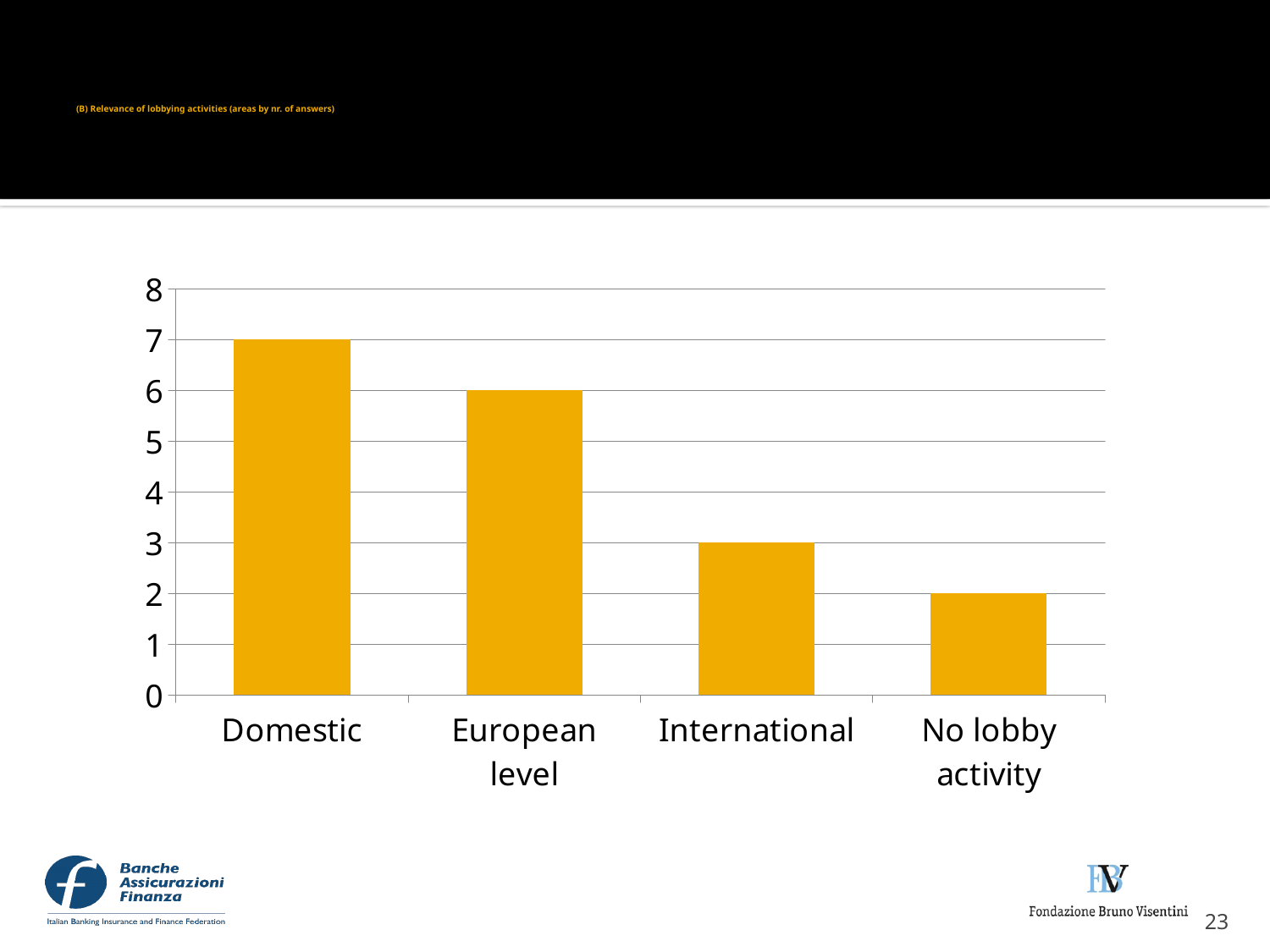
What is the value for European level? 6 Which category has the lowest value? No lobby activity Which category has the highest value? Domestic Which is larger, the value for European level or the value for No lobby activity? European level What is the value for No lobby activity? 2 What is the value for International? 3 What is the difference between the values for Domestic and International? 4 What kind of chart is shown on the slide? bar chart How many categories are shown on the x axis? 4 Is the value for International greater or less than 4? less What is the value for Domestic? 7 Do the values rise or fall from left to right along the x axis? fall